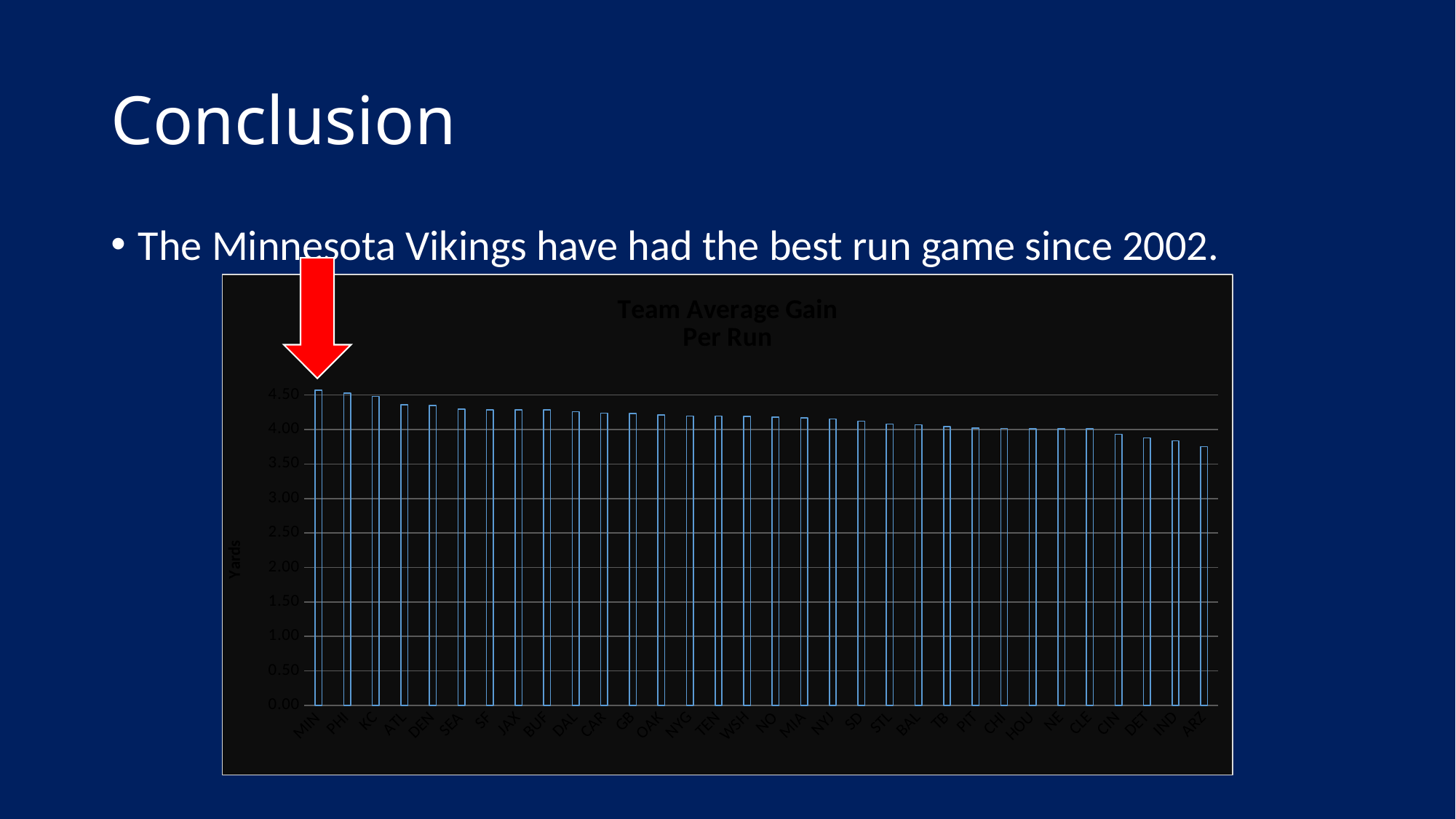
Is the value for IND greater or less than 4.00? less What is the title of the chart? Team Average Gain Per Run Is the value for ATL greater or less than 4.00? greater Do the bar values rise or fall moving from left to right along the x axis? fall What is the label on the vertical axis of the chart? Yards Is the value for KC greater or less than 4.00? greater Which team has the lowest average gain per run in the chart? ARZ Which team has the larger average gain per run, PHI or DET? PHI Which team has the highest average gain per run in the chart? MIN How many teams are shown on the x axis of the chart? 32 What kind of chart is shown on the slide? bar chart